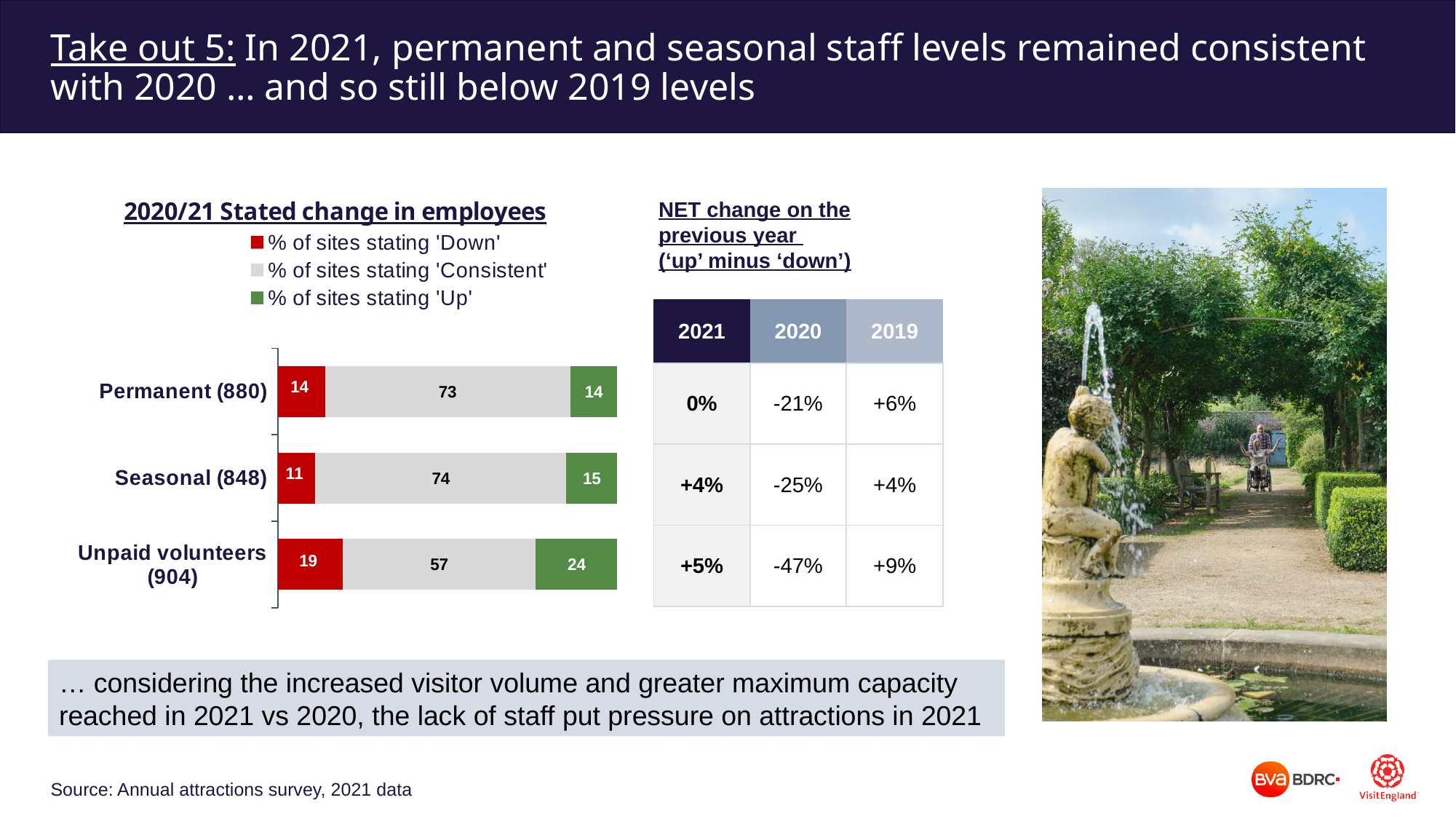
In the '2020/21 Stated change in employees' chart, what is the value for '% of sites stating 'Down'' for Seasonal (848)? 11 What type of chart is shown under the title '2020/21 Stated change in employees'? Stacked bar chart In the '2020/21 Stated change in employees' chart, is the '% of sites stating 'Down'' value larger for Permanent (880) or for Seasonal (848)? Permanent (880) In the '2020/21 Stated change in employees' chart, what is the total of the stacked bar for Seasonal (848)? 100 In the '2020/21 Stated change in employees' chart, which category has the highest value for '% of sites stating 'Down''? Unpaid volunteers (904) How many series does the legend of the '2020/21 Stated change in employees' chart list? 3 In the '2020/21 Stated change in employees' chart, what is the value for '% of sites stating 'Consistent'' for Permanent (880)? 73 How many categories are plotted in the '2020/21 Stated change in employees' chart? 3 In the '2020/21 Stated change in employees' chart, which category has the lowest value for '% of sites stating 'Consistent''? Unpaid volunteers (904) In the '2020/21 Stated change in employees' chart, what is the difference between the '% of sites stating 'Up'' values for Unpaid volunteers (904) and Seasonal (848)? 9 In the '2020/21 Stated change in employees' chart, what is the value for '% of sites stating 'Up'' for Unpaid volunteers (904)? 24 In the '2020/21 Stated change in employees' chart, what colour represents '% of sites stating 'Up''? Green